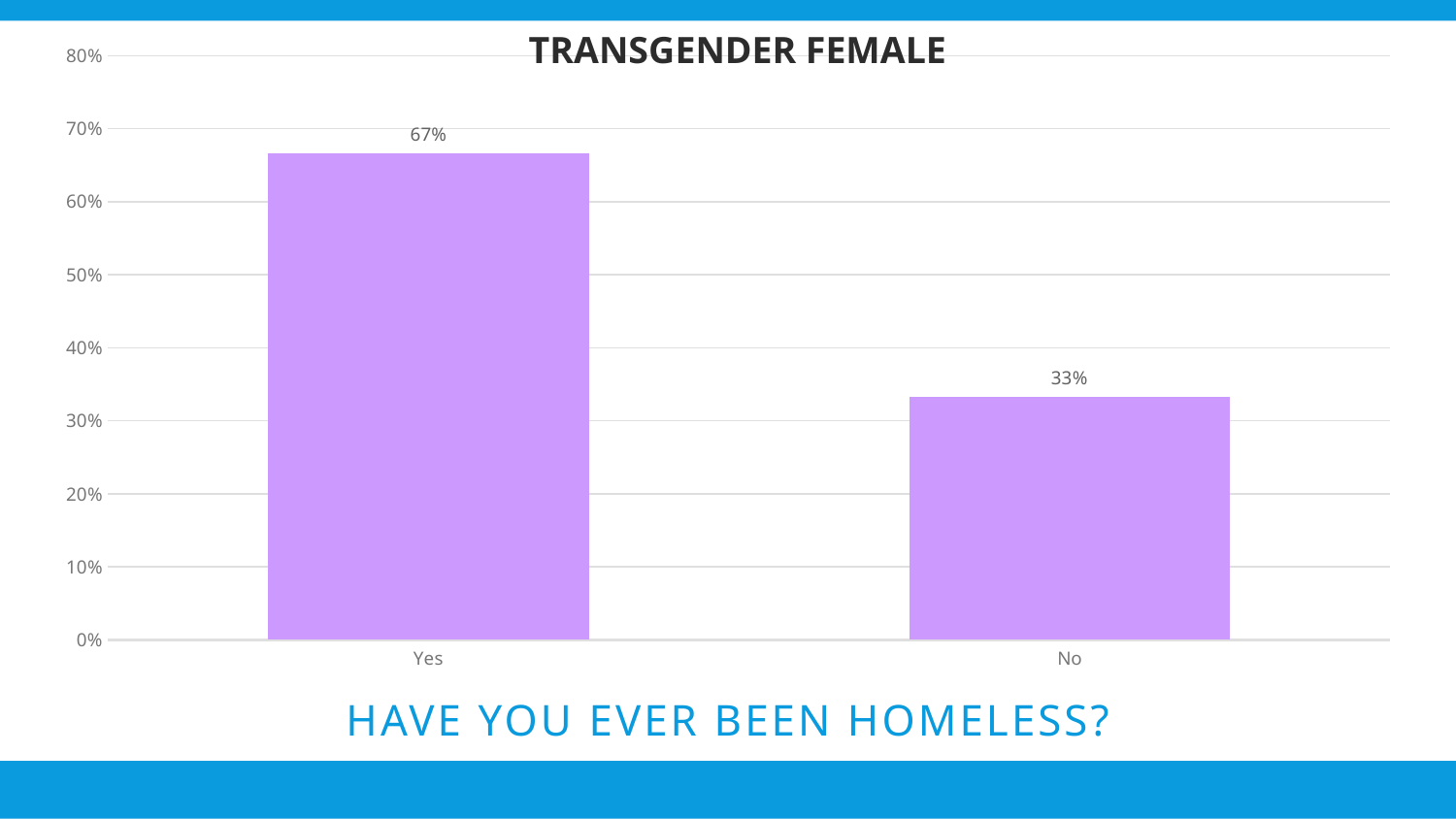
Which category has the lowest value? No What is the value for Yes? 67% What is the title of the chart? TRANSGENDER FEMALE Is the value for Yes greater or less than 60%? greater Which category has the highest value? Yes What kind of chart is shown? bar chart What is the difference between the values for Yes and No? 34% How many categories are shown on the x axis? 2 Is the value for No greater or less than 40%? less What is the value for No? 33% Which is larger, the value for Yes or the value for No? Yes What question is written below the chart? HAVE YOU EVER BEEN HOMELESS?